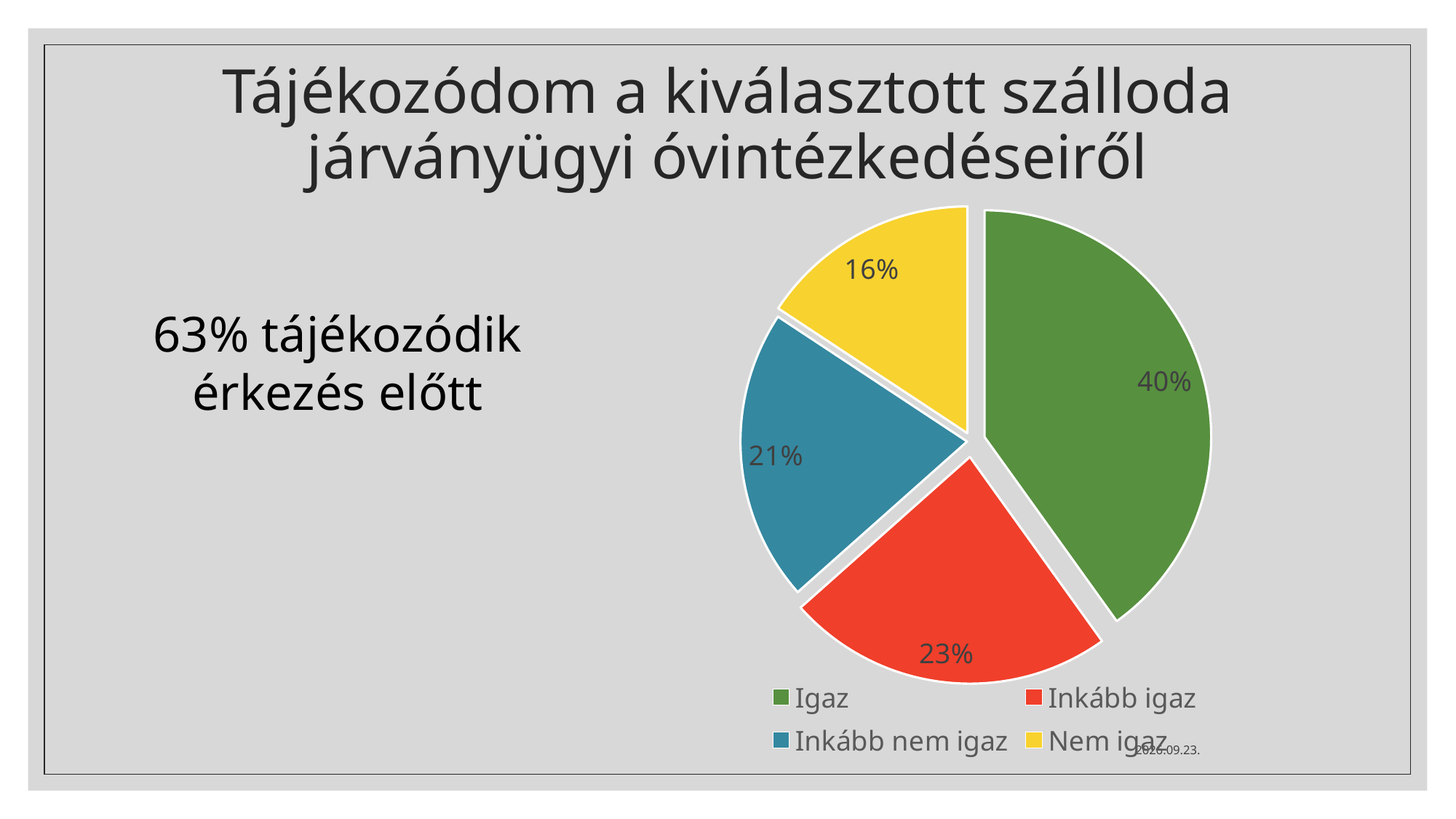
What colour is the slice for "Inkább nem igaz"? blue What is the difference between the shares of "Igaz" and "Nem igaz"? 24% What kind of chart is shown on the slide? pie chart How many categories does the pie chart have? 4 Which is larger, the share of "Igaz" or the share of "Inkább igaz"? Igaz What share of the pie does "Inkább nem igaz" have? 21% What share of the pie does "Inkább igaz" have? 23% Which category has the smallest slice of the pie? Nem igaz What share of the pie does "Nem igaz" have? 16% What is the combined share of "Igaz" and "Inkább igaz"? 63% Which category has the largest slice of the pie? Igaz